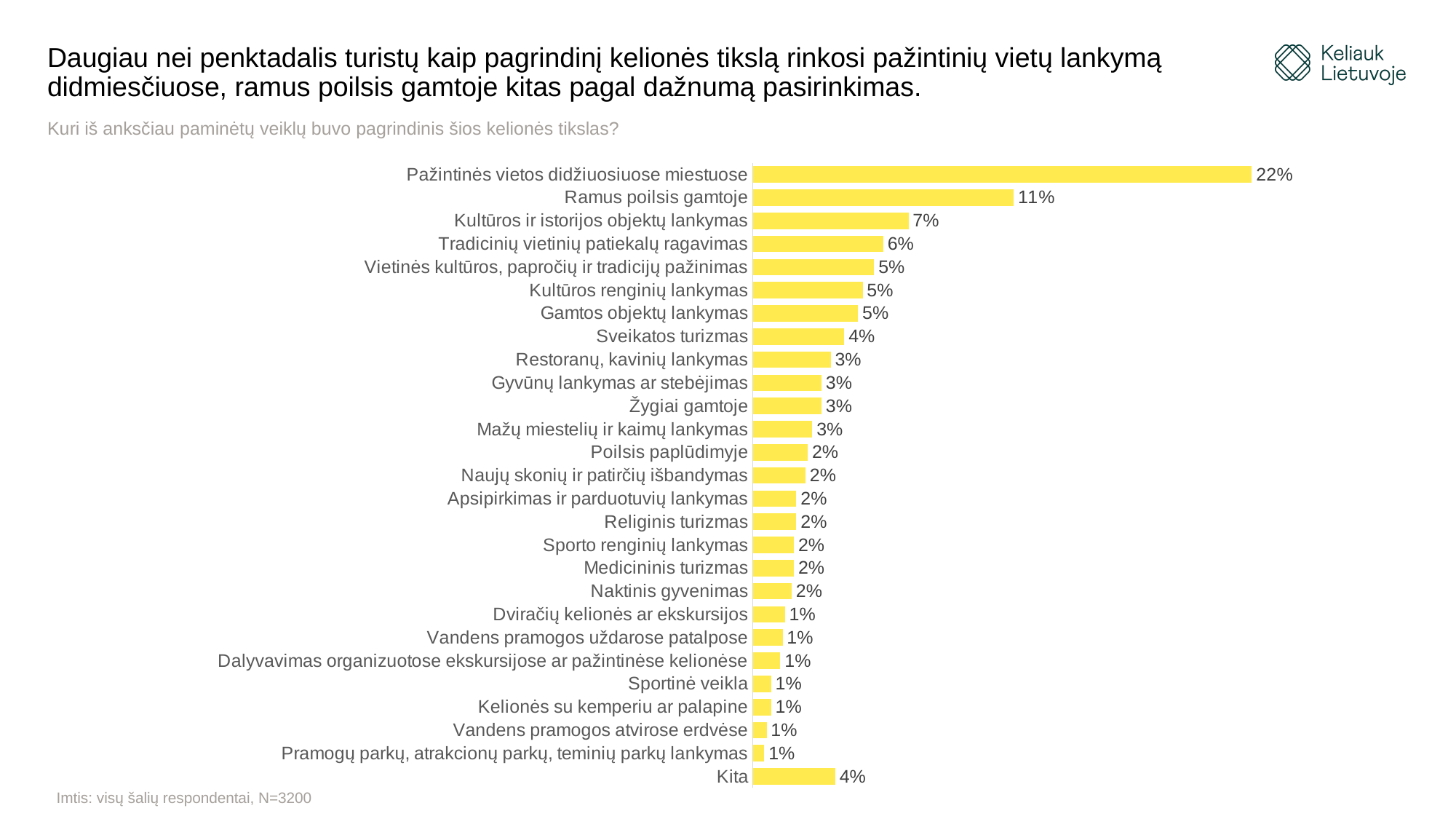
What kind of chart is shown on the slide? Bar chart What is the value for Sveikatos turizmas? 4% What is the value for Tradicinių vietinių patiekalų ragavimas? 6% What is the value for Kita? 4% What is the difference between Kultūros ir istorijos objektų lankymas and Sveikatos turizmas? 3% What is the value for Pažintinės vietos didžiuosiuose miestuose? 22% Which is larger, Ramus poilsis gamtoje or Kultūros ir istorijos objektų lankymas? Ramus poilsis gamtoje What colour are the bars in the chart? Yellow What is the difference between Pažintinės vietos didžiuosiuose miestuose and Ramus poilsis gamtoje? 11% Which category has the highest value? Pažintinės vietos didžiuosiuose miestuose What is the value for Ramus poilsis gamtoje? 11% How many categories are shown in the chart? 27